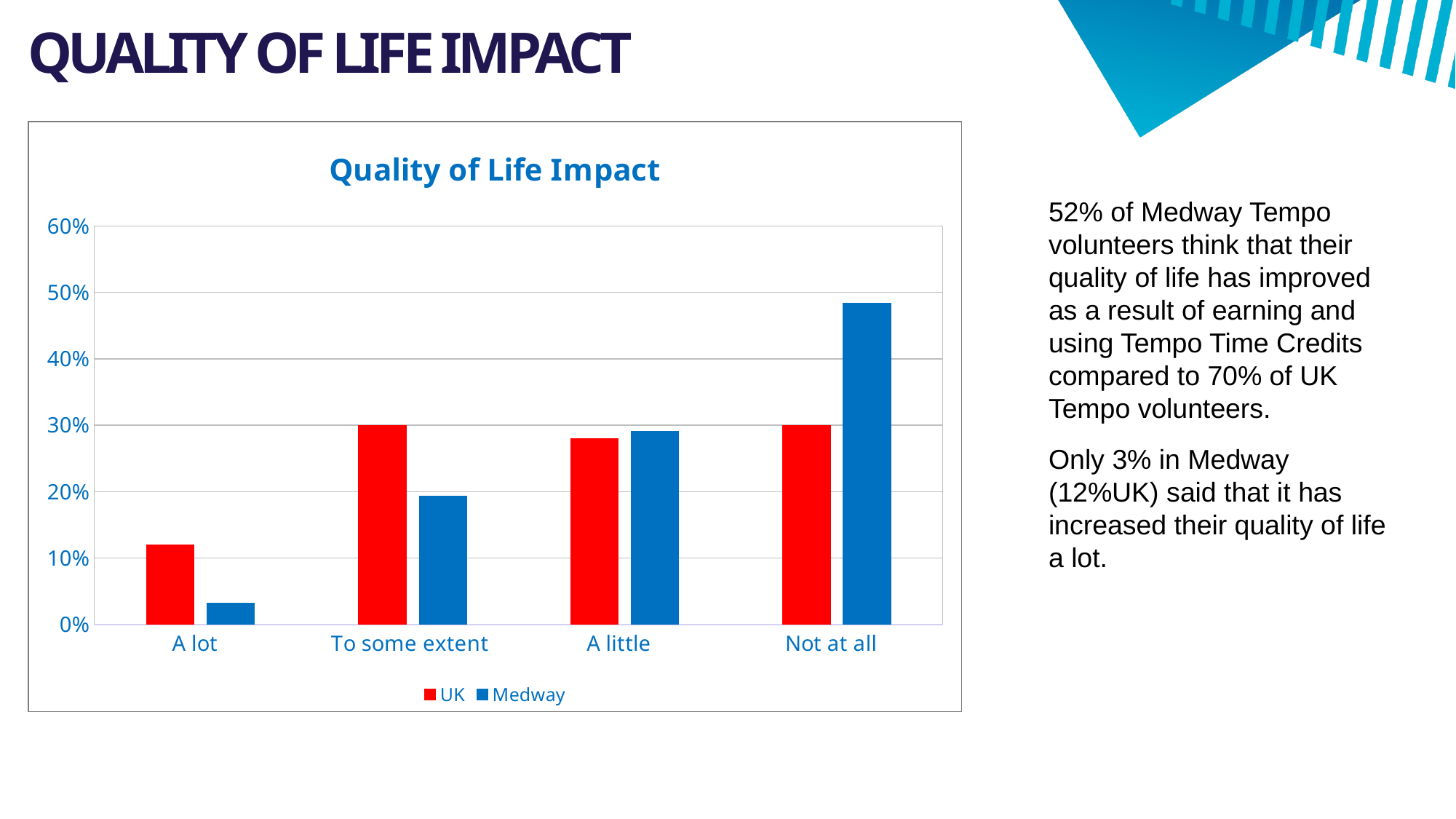
For the 'Not at all' category, which series has the larger value, UK or Medway? Medway Is the Medway value for 'Not at all' greater or less than 40%? greater Which category has the lowest value for UK? A lot What colour represents the Medway series in the chart? blue For the 'A lot' category, which series has the larger value, UK or Medway? UK Which category has the highest value for Medway? Not at all How many series does the legend list? 2 What kind of chart is shown on the slide? bar chart Do the Medway values rise or fall moving from 'A lot' to 'Not at all' along the x axis? rise Is the Medway value for 'A lot' greater or less than 10%? less How many categories are shown on the x axis? 4 Which category has the lowest value for Medway? A lot